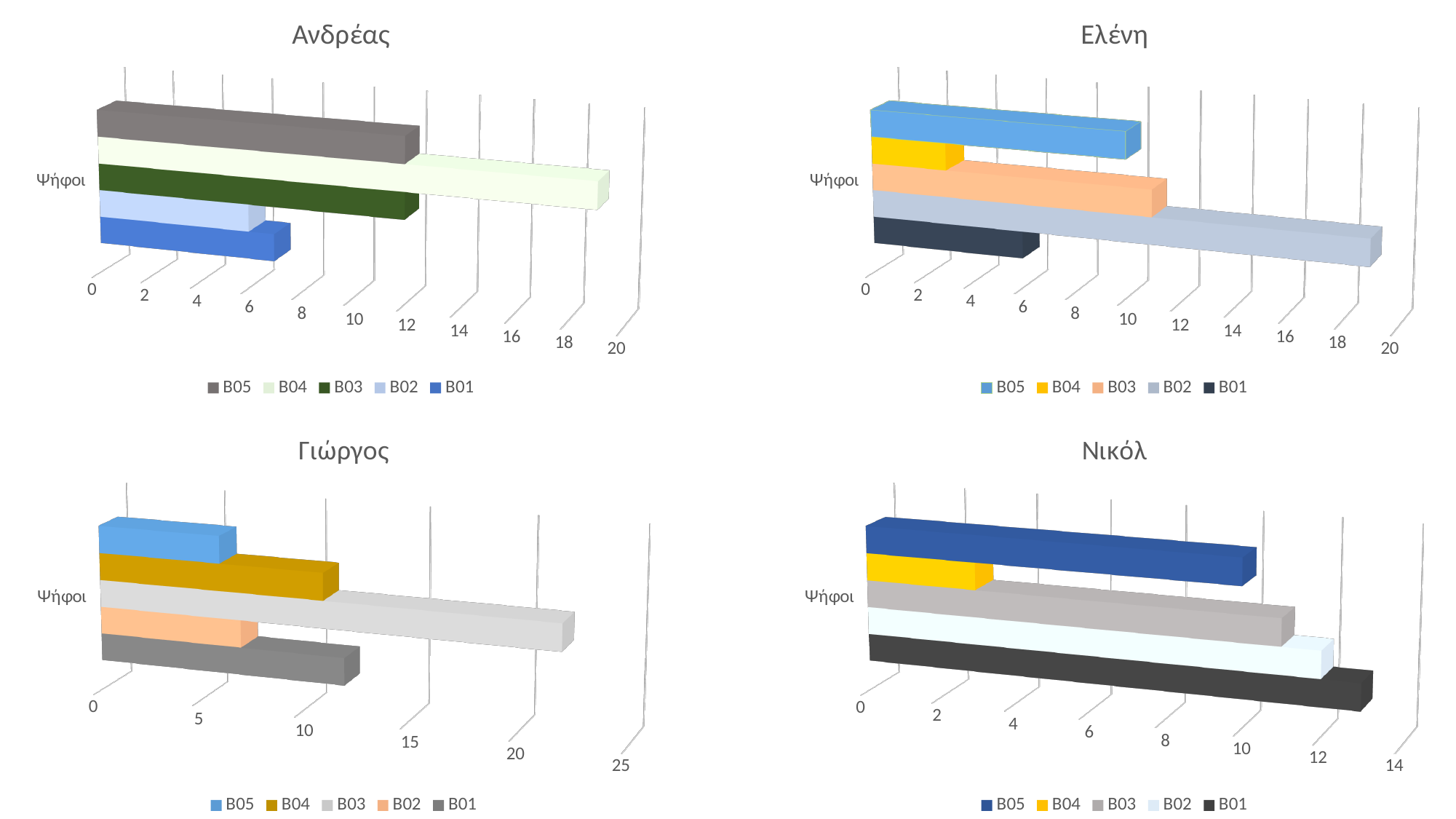
What kind of chart is the chart titled Ανδρέας? bar chart In the chart titled Γιώργος, which is larger, B03 or B04? B03 In the chart titled Νικόλ, is the value for B04 greater or less than 6? less In the chart titled Ανδρέας, which series has the highest value? B04 How many series does the legend of the chart titled Ελένη list? 5 In the chart titled Γιώργος, which series has the highest value? B03 In the chart titled Γιώργος, is the value for B03 greater or less than 15? greater What is the category label shown on the vertical axis of the chart titled Νικόλ? Ψήφοι In the chart titled Ελένη, which series has the highest value? B02 In the chart titled Ελένη, which series has the lowest value? B04 In the chart titled Ανδρέας, is the value for B04 greater or less than 16? greater In the chart titled Νικόλ, which series has the lowest value? B04